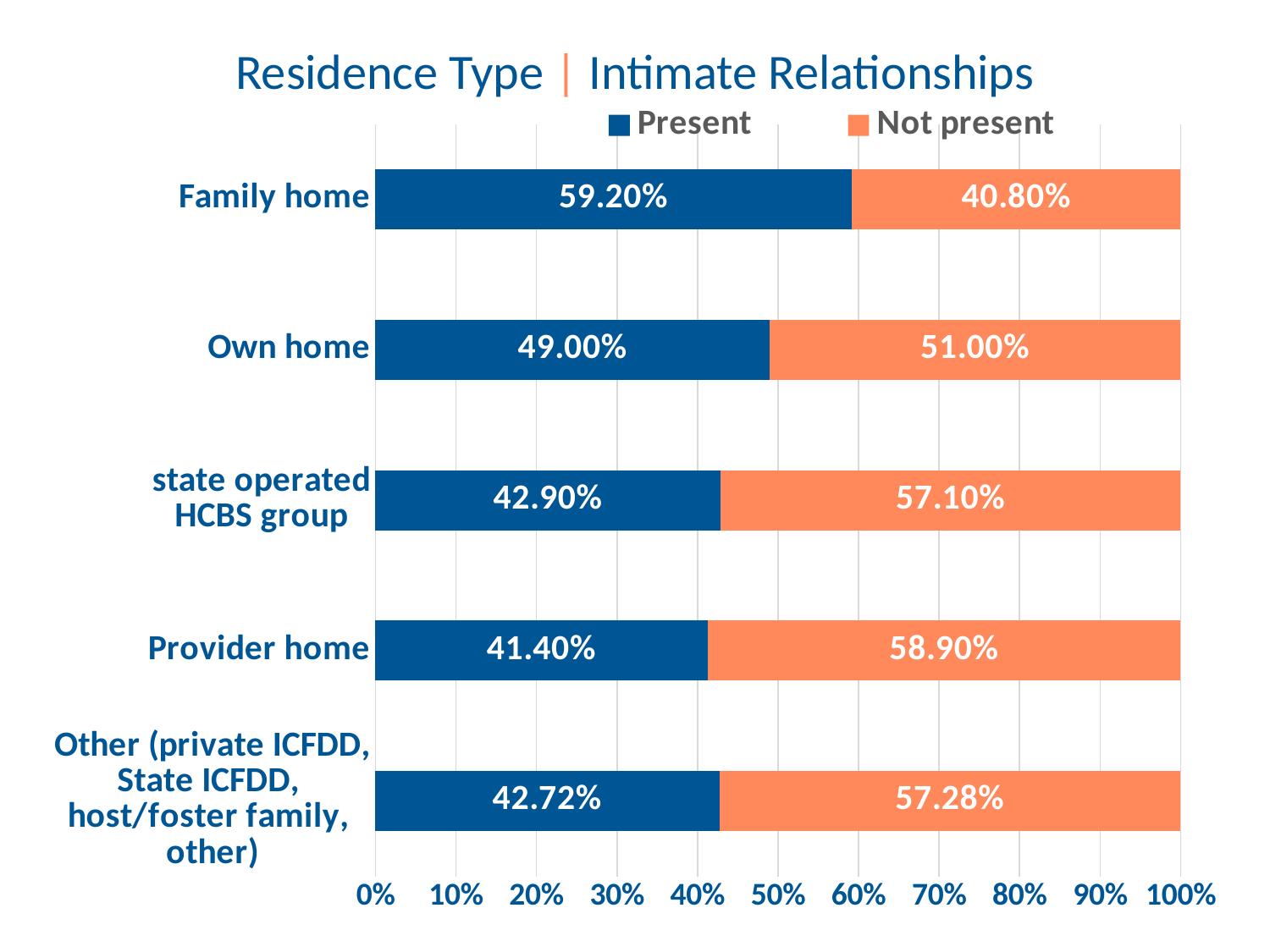
What is the difference between the 'Present' and 'Not present' values for Family home? 18.40% How many series does the legend list? 2 What is the 'Not present' value for Own home? 51.00% What is the 'Not present' value for state operated HCBS group? 57.10% What is the title of the chart? Residence Type | Intimate Relationships What kind of chart is shown on the slide? Stacked bar chart What is the 'Present' value for Provider home? 41.40% Which is larger for Own home: 'Present' or 'Not present'? Not present What is the 'Present' value for Family home? 59.20% How many residence type categories are shown in the chart? 5 Which residence type has the lowest 'Present' value? Provider home Which residence type has the highest 'Present' value? Family home